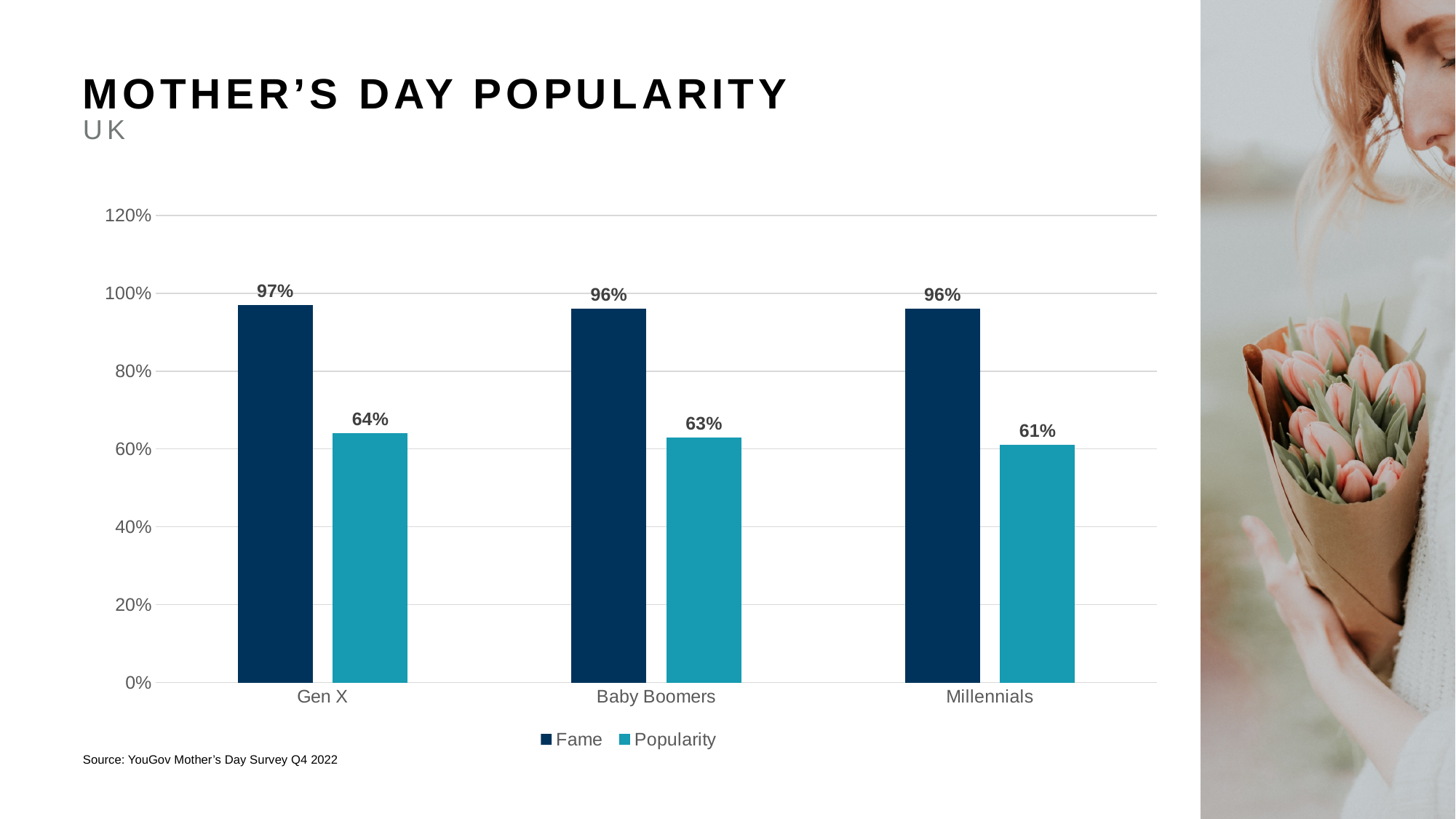
Which generation has the lowest Popularity value? Millennials How many generation categories are shown on the x axis? 3 Which generation has the highest Popularity value? Gen X How many series does the legend list? 2 Which is larger for Baby Boomers, Fame or Popularity? Fame What is the Fame value for Gen X? 97% What is the difference between the Fame and Popularity values for Gen X? 33% What kind of chart is shown on the slide? Bar chart What are the two series named in the legend? Fame and Popularity What is the Popularity value for Baby Boomers? 63% What is the Popularity value for Millennials? 61% What is the difference between the Popularity values for Gen X and Millennials? 3%